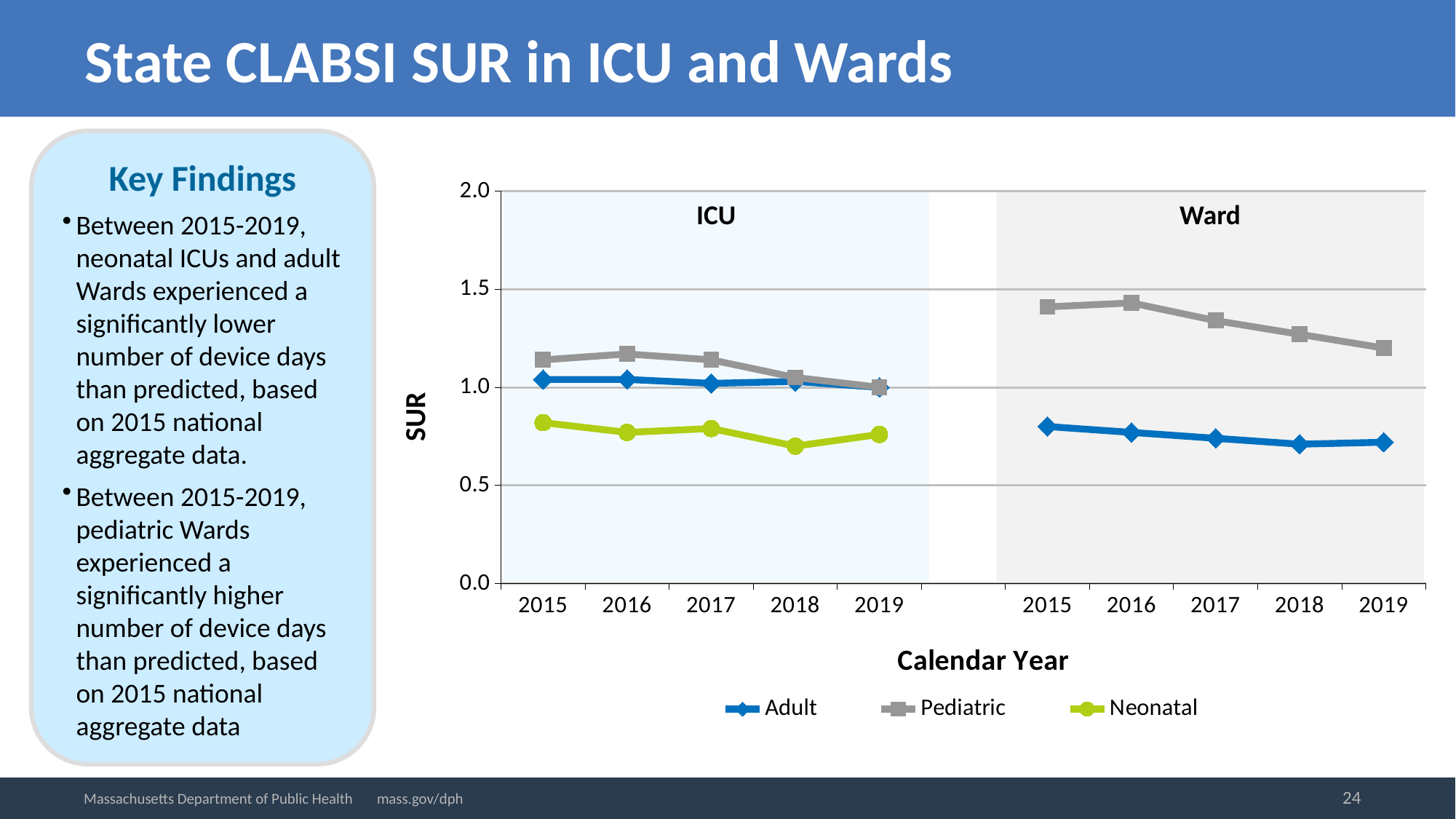
What is the label on the y axis of the chart? SUR Which legend series is not plotted in the Ward panel? Neonatal In the Ward panel, is the Adult SUR for 2015 greater or less than 1.0? less In the ICU panel, is the Neonatal SUR for 2018 greater or less than 0.5? greater In the Ward panel, is the Pediatric SUR for 2015 greater or less than 1.5? less In the ICU panel, which year has the lowest Neonatal SUR? 2018 In the Ward panel, does the Pediatric SUR rise or fall from 2016 to 2019? fall What type of chart is shown on the slide? line chart In the Ward panel, which is larger in 2019, the Pediatric SUR or the Adult SUR? Pediatric How many calendar years are plotted in the ICU panel? 5 How many series does the legend list? 3